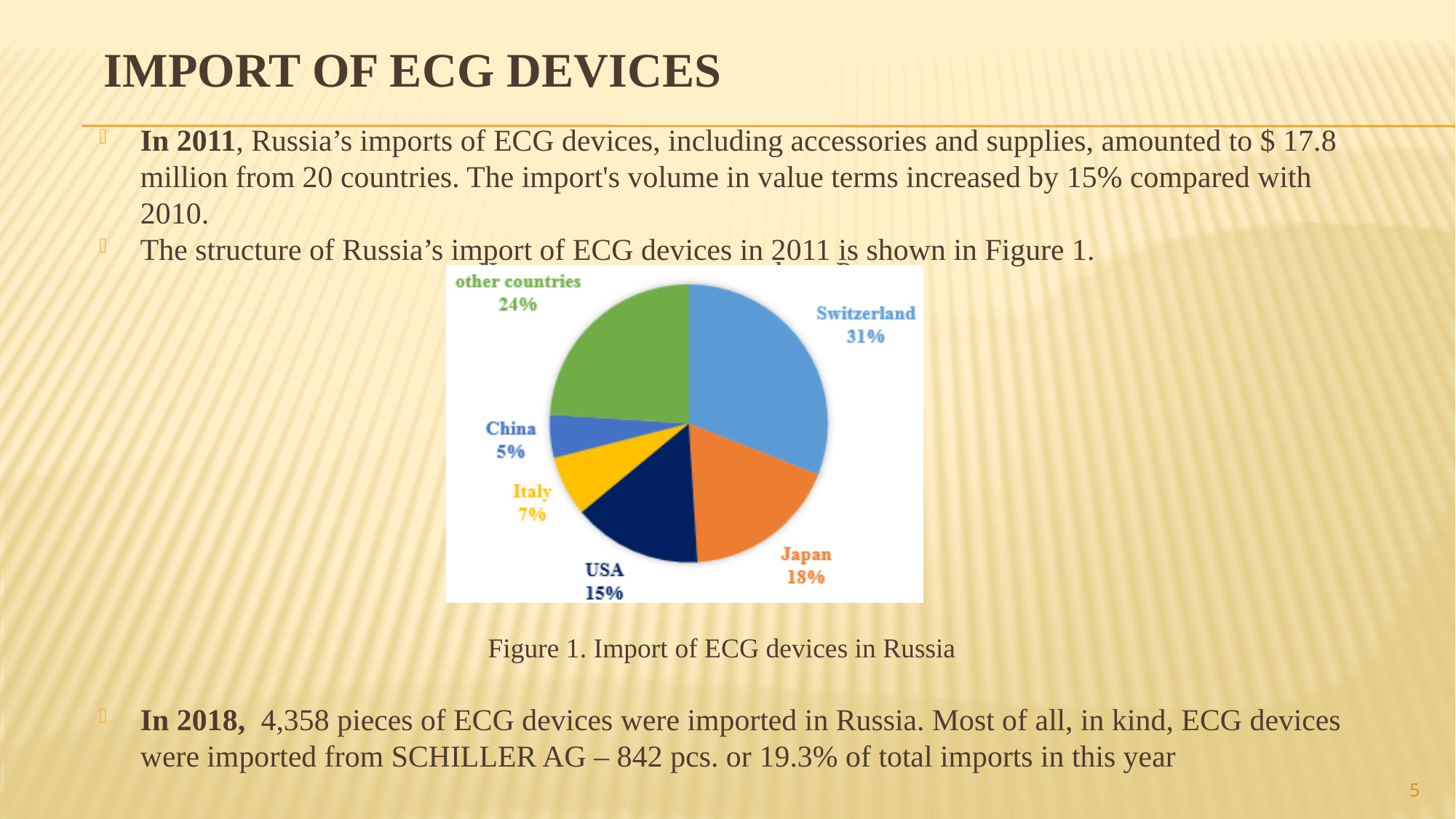
What percentage of ECG device imports came from the USA? 15% What share of Russia's ECG device imports came from Switzerland? 31% Which has a larger share of imports, the USA or Italy? USA Which country has the largest share of ECG device imports in the pie chart? Switzerland How many percentage points larger is Switzerland's share than Japan's? 13 What type of chart is shown in Figure 1? Pie chart What share of the pie chart is labelled Japan? 18% How many slices does the pie chart have? 6 What share does China hold in the pie chart? 5% What share of imports is attributed to other countries? 24% What share does Italy hold in the pie chart? 7% Which named country has the smallest share in the pie chart? China